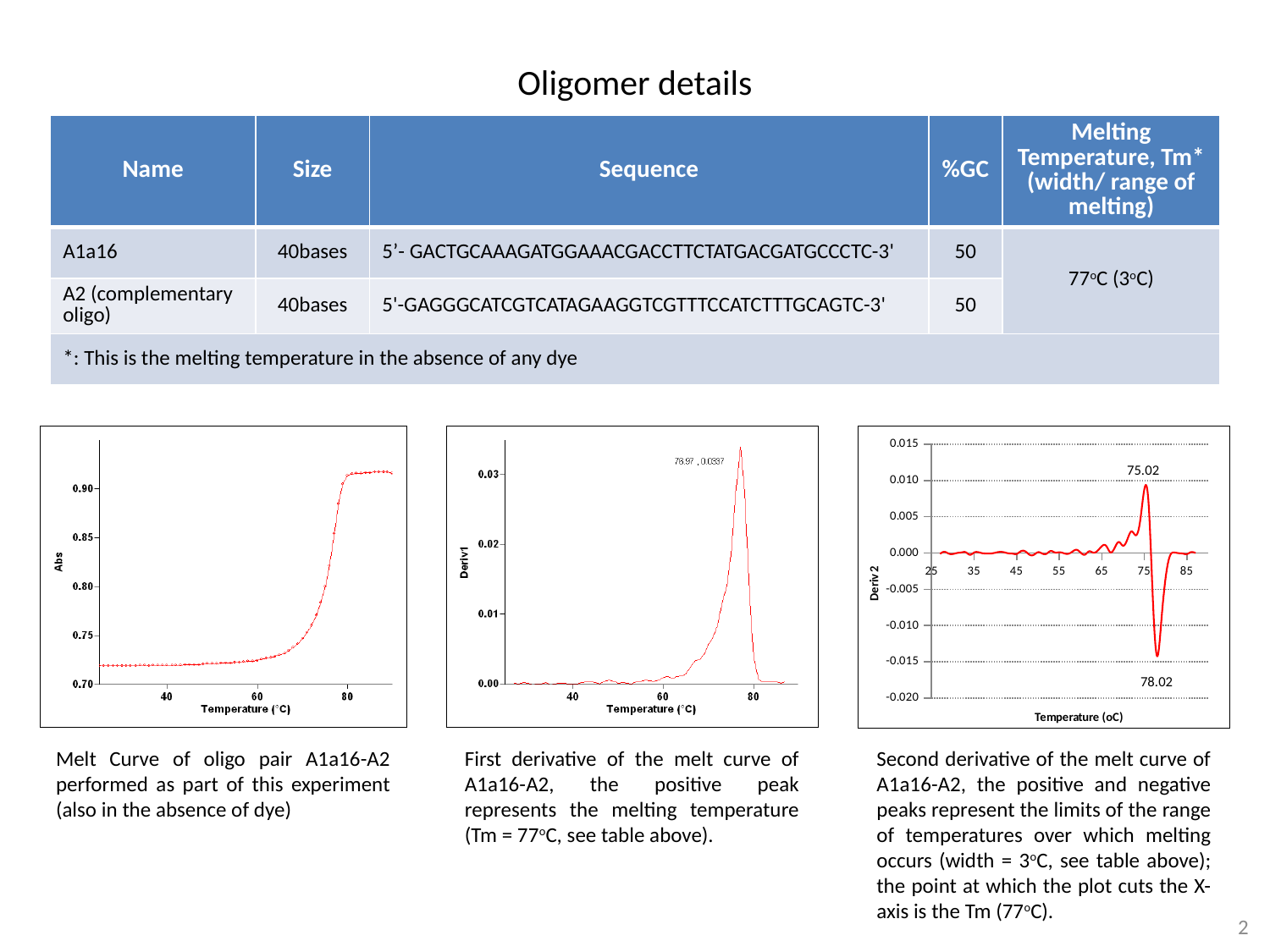
In the rightmost chart (Deriv 2 vs Temperature), what label is printed at the negative peak? 78.02 In the rightmost chart (Deriv 2 vs Temperature), what label is printed at the positive peak? 75.02 What kind of chart is the leftmost chart (Abs vs Temperature)? line chart In the rightmost chart (Deriv 2 vs Temperature), what is the difference between the labelled negative-peak temperature (78.02) and the labelled positive-peak temperature (75.02)? 3 In the middle chart (Deriv1 vs Temperature), at what temperature does the labelled peak occur? 76.97 What is the y-axis title of the rightmost chart? Deriv 2 In the rightmost chart (Deriv 2 vs Temperature), is the value at the negative peak greater or less than -0.010? less In the leftmost chart (Abs vs Temperature), does the Abs value rise or fall as temperature increases? rises In the leftmost chart (Abs vs Temperature), is the Abs value at 80 °C greater or less than 0.85? greater In the middle chart (Deriv1 vs Temperature), what data label is printed at the peak? 76.97, 0.0337 In the middle chart (Deriv1 vs Temperature), what is the Deriv1 value at the labelled peak? 0.0337 In the leftmost chart (Abs vs Temperature), is the Abs value at 40 °C greater or less than 0.75? less